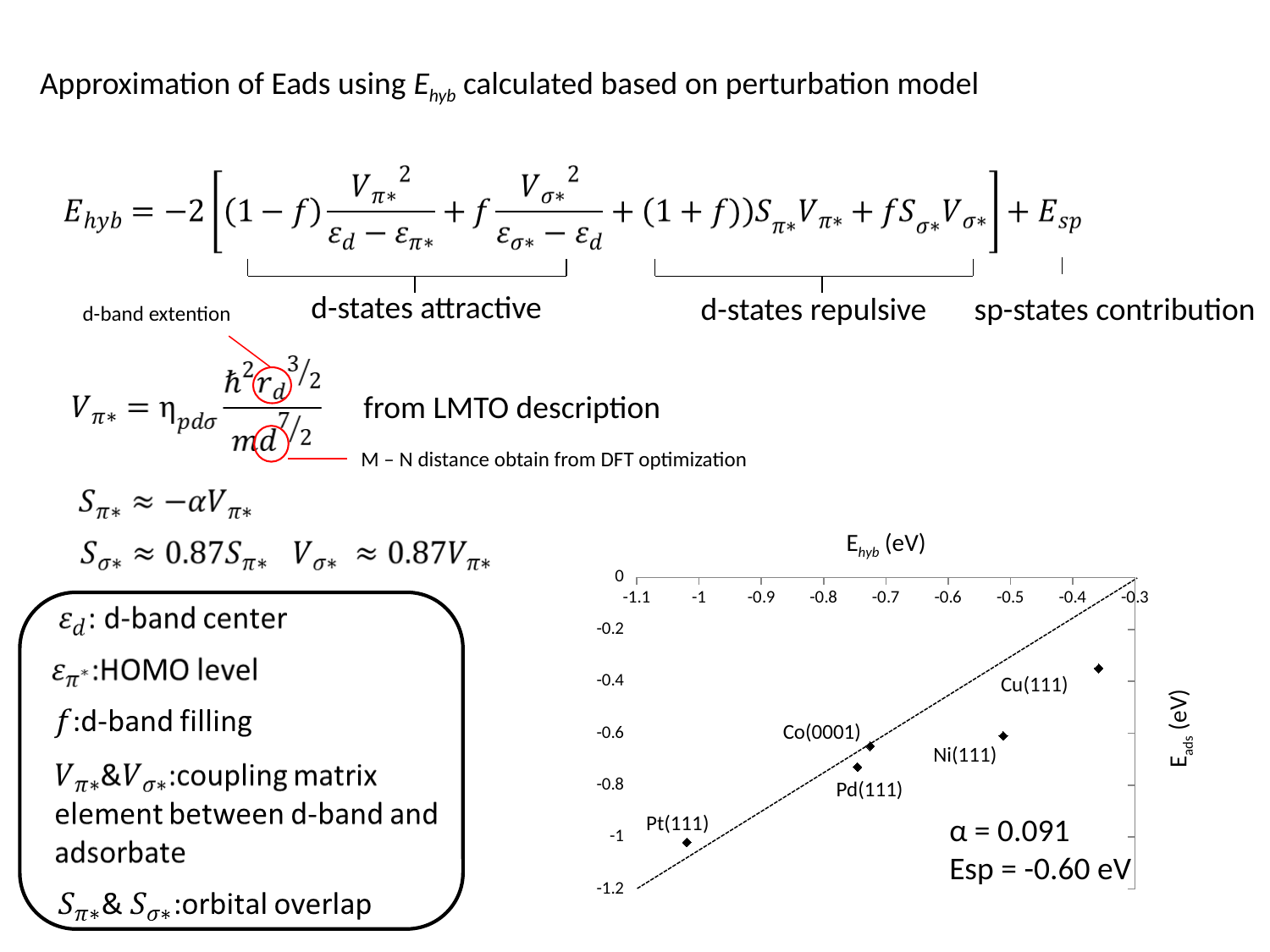
Which metal surface has the highest E_ads value in the scatter chart? Cu(111) Is the E_hyb value for Pt(111) greater or less than -0.9? less Is the E_ads value for Cu(111) greater or less than -0.4? greater Do the E_ads values rise or fall as E_hyb increases along the x axis? rise Which has the higher E_ads value, Ni(111) or Pd(111)? Ni(111) Which has the higher E_hyb value, Cu(111) or Pt(111)? Cu(111) What is the title of the x axis of the scatter chart? E_hyb (eV) Is the E_ads value for Ni(111) greater or less than -0.8? greater How many labelled data points are plotted in the scatter chart? 5 What kind of chart is shown on the slide? scatter chart Which metal surface has the lowest E_ads value in the scatter chart? Pt(111)